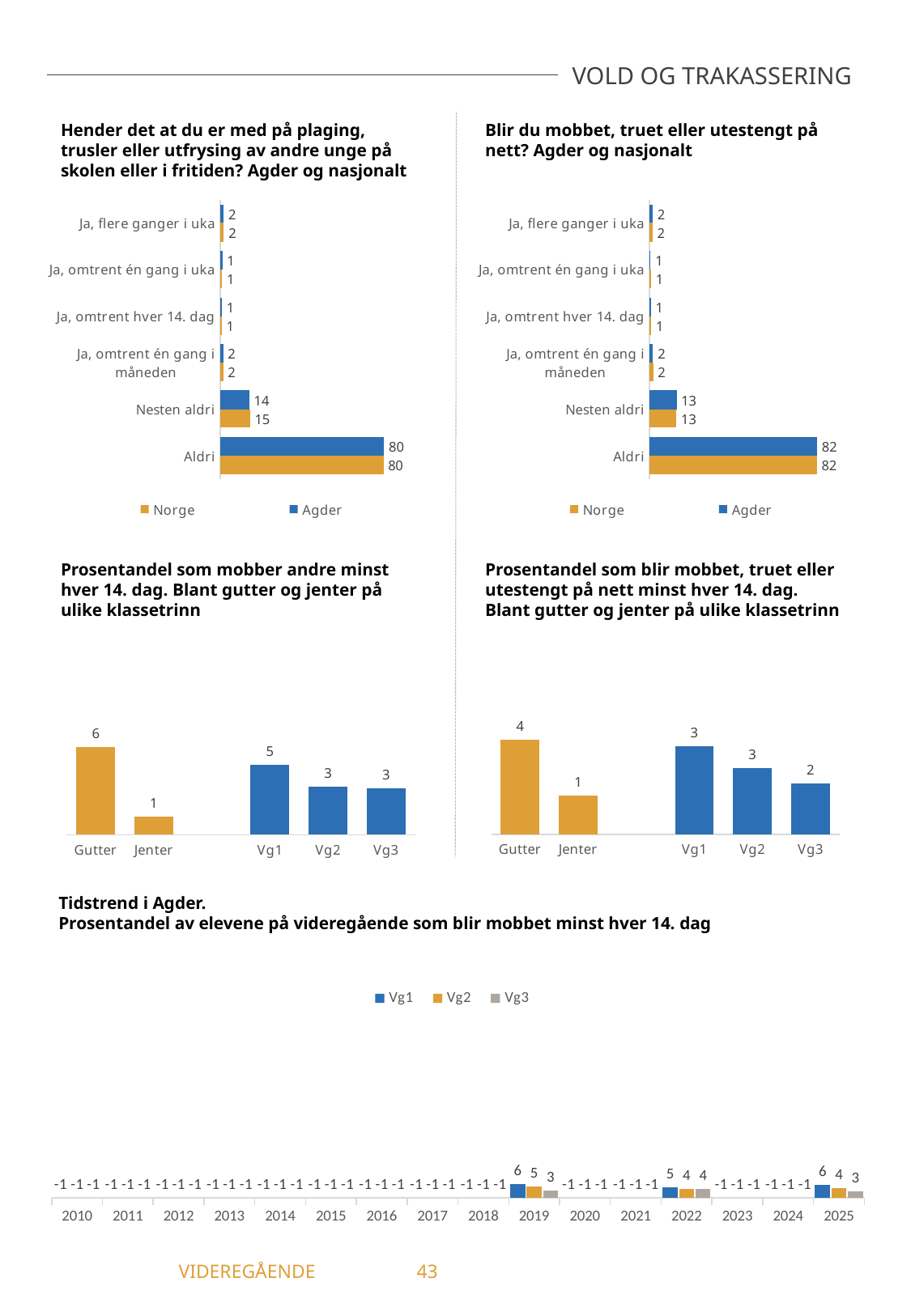
In the chart 'Blir du mobbet, truet eller utestengt på nett? Agder og nasjonalt', which category has the highest values? Aldri In the chart 'Prosentandel som blir mobbet, truet eller utestengt på nett minst hver 14. dag. Blant gutter og jenter på ulike klassetrinn', which is larger, the value for Vg1 or the value for Vg3? Vg1 In the chart 'Hender det at du er med på plaging, trusler eller utfrysing av andre unge på skolen eller i fritiden? Agder og nasjonalt', what is the value for Agder in the 'Aldri' category? 80 In the chart 'Prosentandel som mobber andre minst hver 14. dag. Blant gutter og jenter på ulike klassetrinn', what is the value for Gutter? 6 In the chart 'Prosentandel som blir mobbet, truet eller utestengt på nett minst hver 14. dag. Blant gutter og jenter på ulike klassetrinn', what is the difference between the values for Gutter and Jenter? 3 In the chart 'Blir du mobbet, truet eller utestengt på nett? Agder og nasjonalt', what is the value for Agder in the 'Nesten aldri' category? 13 In the chart 'Tidstrend i Agder. Prosentandel av elevene på videregående som blir mobbet minst hver 14. dag', what is the value for Vg2 in 2022? 4 In the chart 'Hender det at du er med på plaging, trusler eller utfrysing av andre unge på skolen eller i fritiden? Agder og nasjonalt', how many series does the legend list? 2 In the chart 'Hender det at du er med på plaging, trusler eller utfrysing av andre unge på skolen eller i fritiden? Agder og nasjonalt', what is the value for Norge in the 'Nesten aldri' category? 15 In the chart 'Prosentandel som mobber andre minst hver 14. dag. Blant gutter og jenter på ulike klassetrinn', which category has the lowest value? Jenter In the chart 'Prosentandel som mobber andre minst hver 14. dag. Blant gutter og jenter på ulike klassetrinn', what kind of chart is it? Bar chart In the chart 'Blir du mobbet, truet eller utestengt på nett? Agder og nasjonalt', what is the difference between the Agder values for 'Aldri' and 'Nesten aldri'? 69